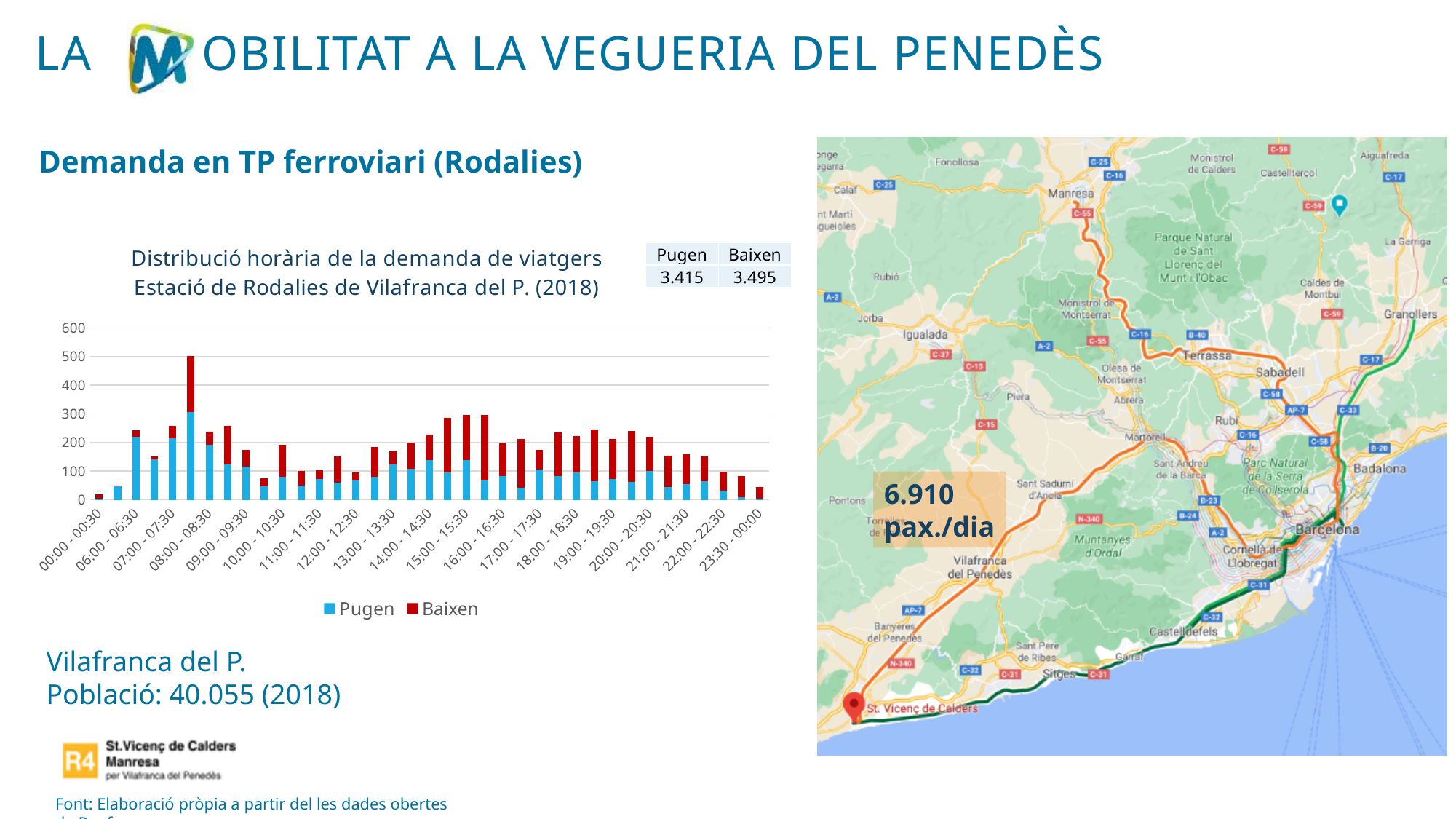
Which stacked bar is taller, 08:00 - 08:30 or 22:00 - 22:30? 08:00 - 08:30 According to the table next to the chart, what is the total Pugen value? 3.415 Do the stacked bar totals rise or fall from 19:00 - 19:30 to 23:30 - 00:00? fall What are the two series named in the chart legend? Pugen and Baixen Which station does the chart title say the hourly demand distribution refers to? Estació de Rodalies de Vilafranca del P. (2018) What kind of chart is shown on the slide? Stacked bar chart How many series does the chart legend list? 2 Is the total stacked value for the 00:00 - 00:30 bar greater or less than 100? less Is the total stacked value for the 08:00 - 08:30 bar greater or less than 400? less According to the table next to the chart, which total is larger, Pugen or Baixen? Baixen